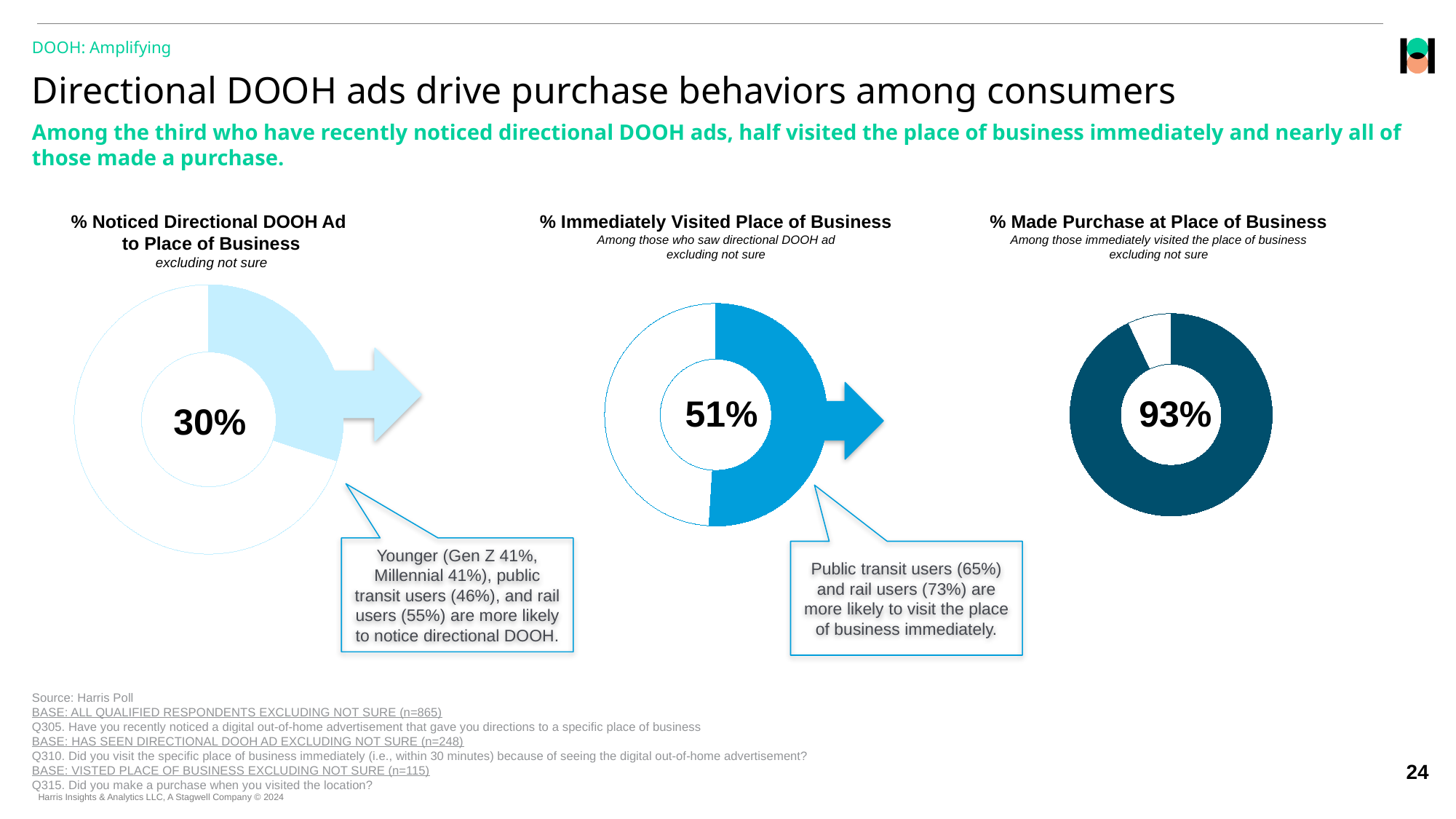
According to the callout next to the "% Immediately Visited Place of Business" chart, what percentage of rail users visited the place of business immediately? 73% What is the difference between the value in the "% Made Purchase at Place of Business" chart and the value in the "% Immediately Visited Place of Business" chart? 42 percentage points In the chart titled "% Noticed Directional DOOH Ad to Place of Business", what value is shown in the center of the donut? 30% Which of the three charts shows the lowest percentage? % Noticed Directional DOOH Ad to Place of Business In the "% Made Purchase at Place of Business" chart, what share of the donut does the filled (dark) slice represent? 93% Which of the three charts shows the highest percentage? % Made Purchase at Place of Business What kind of chart is used for the three charts on this slide? Donut (pie) chart Is the value in the "% Immediately Visited Place of Business" chart larger or smaller than the value in the "% Noticed Directional DOOH Ad to Place of Business" chart? Larger In the chart titled "% Made Purchase at Place of Business", what value is shown in the center of the donut? 93% In the chart titled "% Immediately Visited Place of Business", what value is shown in the center of the donut? 51% What is the difference between the value in the "% Immediately Visited Place of Business" chart and the value in the "% Noticed Directional DOOH Ad to Place of Business" chart? 21 percentage points How many donut charts are shown on the slide? 3